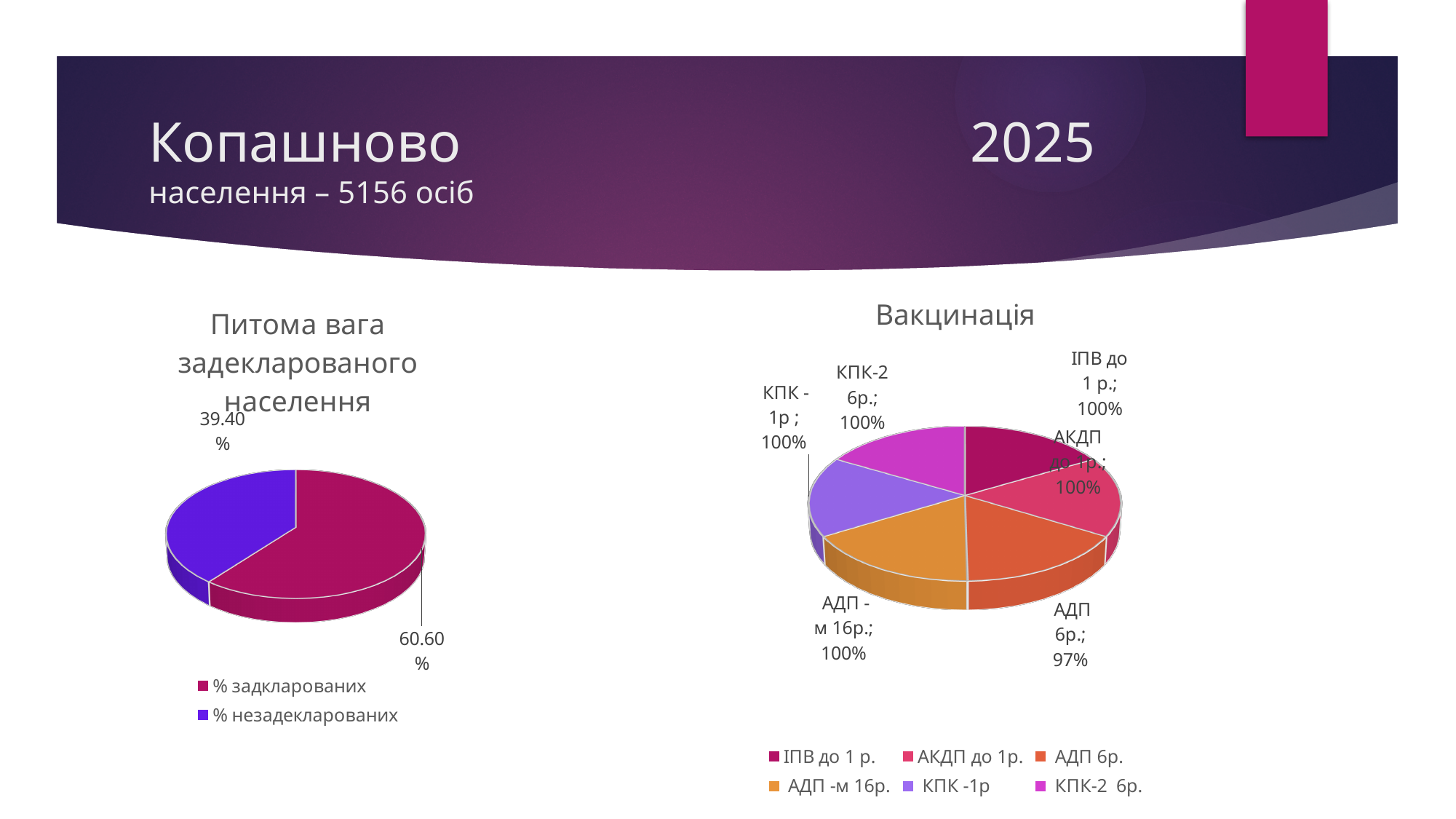
In the 'Питома вага задекларованого населення' chart, what is the value for '% незадекларованих'? 39.40% In the 'Вакцинація' chart, what is the value for 'КПК-2 6р.'? 100% In the 'Вакцинація' chart, which category has the lowest value? АДП 6р. In the 'Вакцинація' chart, what is the value for 'АДП 6р.'? 97% What kind of chart is the 'Питома вага задекларованого населення' chart? pie chart In the 'Питома вага задекларованого населення' chart, which slice is larger: '% задкларованих' or '% незадекларованих'? % задкларованих How many slices does the 'Вакцинація' chart have? 6 How many entries does the legend of the 'Питома вага задекларованого населення' chart list? 2 In the 'Вакцинація' chart, what colour is the 'ІПВ до 1 р.' slice? dark magenta What kind of chart is the 'Вакцинація' chart? pie chart In the 'Питома вага задекларованого населення' chart, what is the value for '% задкларованих'? 60.60% In the 'Питома вага задекларованого населення' chart, what is the difference between '% задкларованих' and '% незадекларованих'? 21.20%